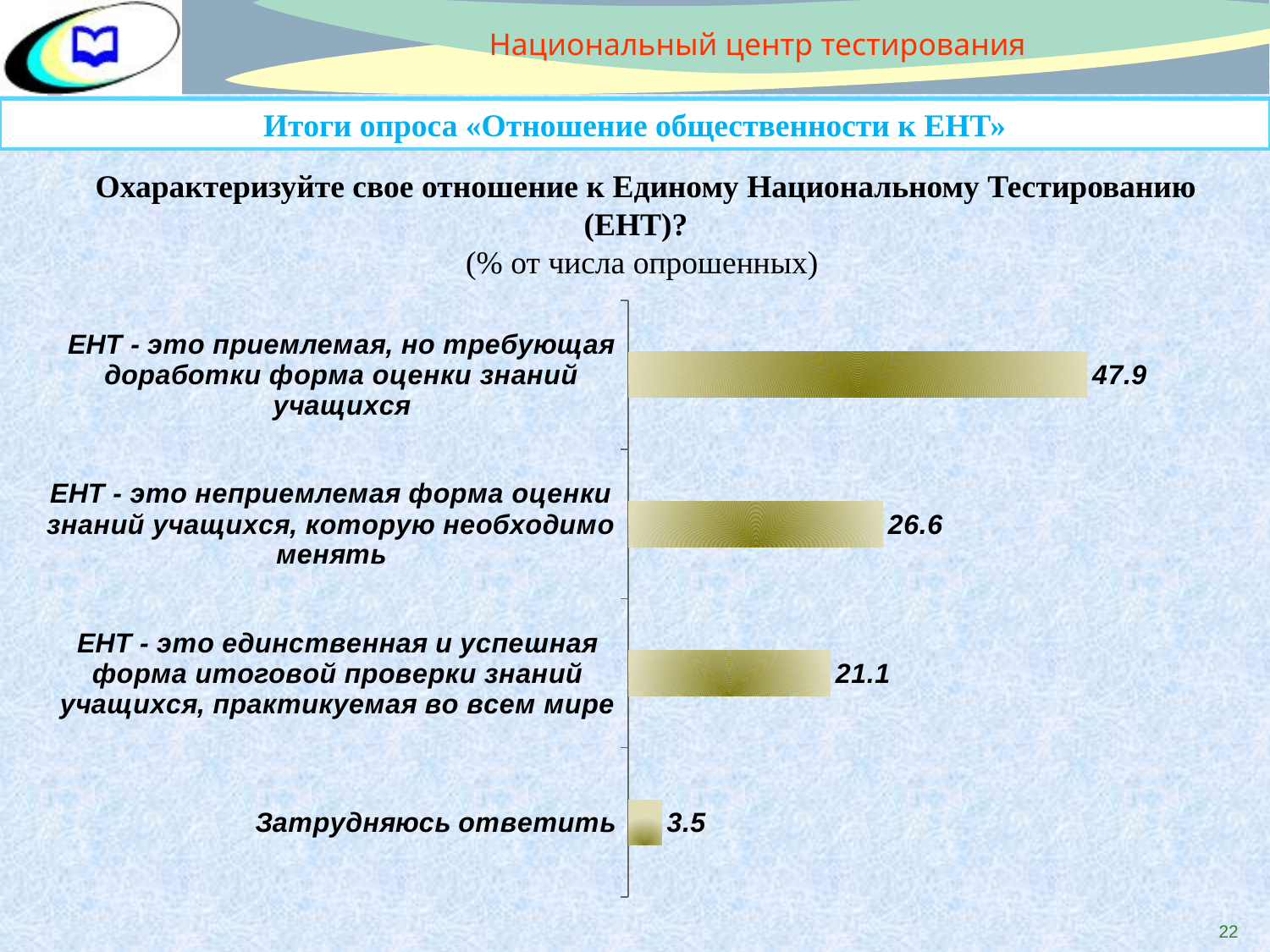
How many categories are shown in the chart? 4 What value is shown for the category "Затрудняюсь ответить"? 3.5 What value is shown for "ЕНТ - это единственная и успешная форма итоговой проверки знаний учащихся, практикуемая во всем мире"? 21.1 Which category has the lowest value? Затрудняюсь ответить What value is shown for "ЕНТ - это приемлемая, но требующая доработки форма оценки знаний учащихся"? 47.9 What is the difference between the values for "ЕНТ - это приемлемая, но требующая доработки форма оценки знаний учащихся" and "ЕНТ - это неприемлемая форма оценки знаний учащихся, которую необходимо менять"? 21.3 Which category has the highest value? ЕНТ - это приемлемая, но требующая доработки форма оценки знаний учащихся What is the difference between the values for "ЕНТ - это неприемлемая форма оценки знаний учащихся, которую необходимо менять" and "ЕНТ - это единственная и успешная форма итоговой проверки знаний учащихся, практикуемая во всем мире"? 5.5 What question is the chart based on, according to the heading above it? Охарактеризуйте свое отношение к Единому Национальному Тестированию (ЕНТ)? What value is shown for "ЕНТ - это неприемлемая форма оценки знаний учащихся, которую необходимо менять"? 26.6 What kind of chart is shown on the slide? Bar chart Which is larger: the value for "ЕНТ - это неприемлемая форма оценки знаний учащихся, которую необходимо менять" or for "ЕНТ - это единственная и успешная форма итоговой проверки знаний учащихся, практикуемая во всем мире"? ЕНТ - это неприемлемая форма оценки знаний учащихся, которую необходимо менять